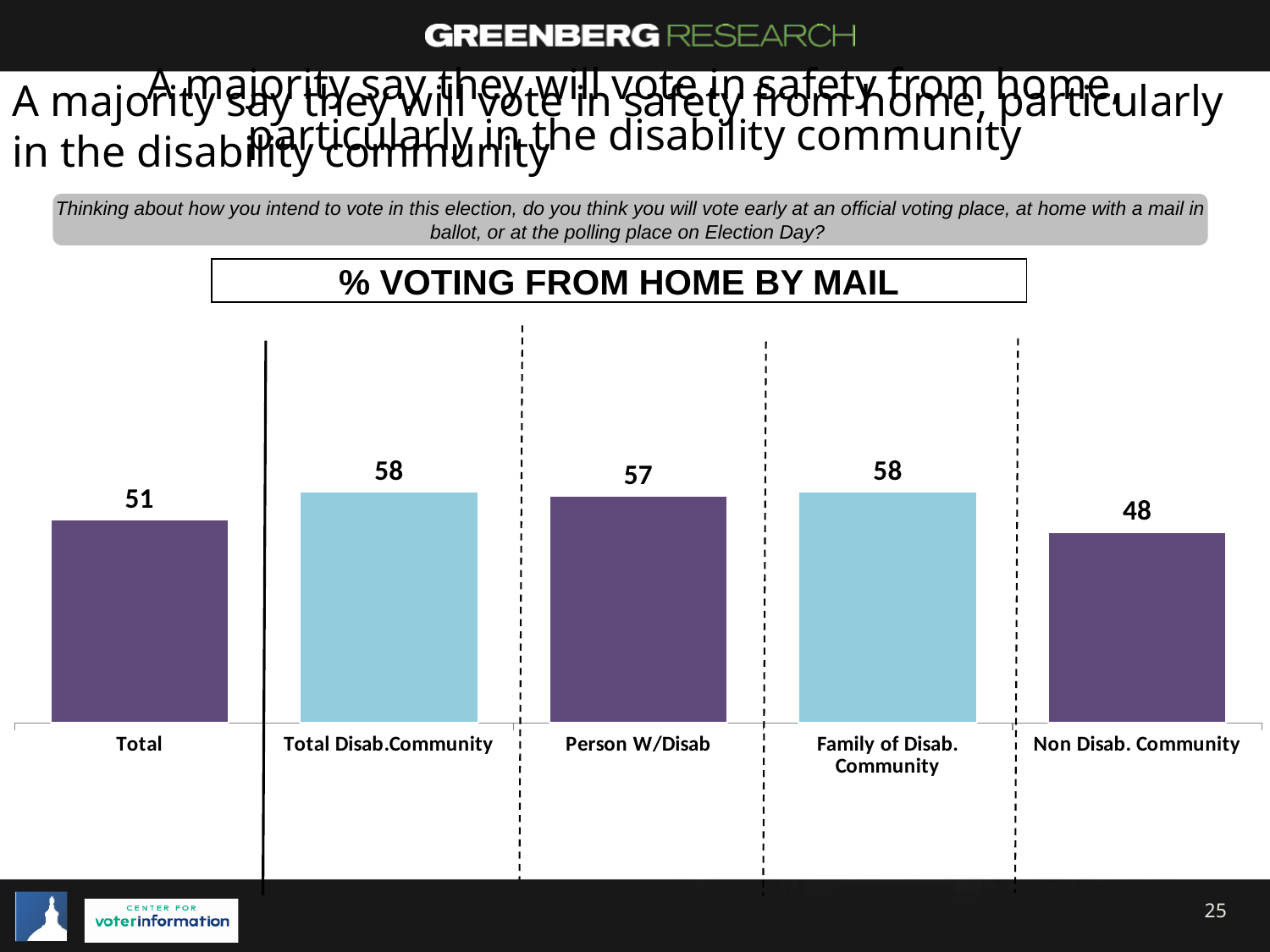
Which category has the lowest value? Non Disab. Community How many categories are shown in the chart? 5 What is the title of the chart? % VOTING FROM HOME BY MAIL What is the value for Person W/Disab? 57 What is the difference between the values for Total Disab.Community and Non Disab. Community? 10 What kind of chart is shown on the slide? Bar chart What is the value for Family of Disab. Community? 58 What is the difference between the values for Person W/Disab and Total? 6 What is the value for Total? 51 What is the value for Non Disab. Community? 48 Which two categories share the highest value of 58? Total Disab.Community and Family of Disab. Community Which is larger, the value for Total Disab.Community or the value for Total? Total Disab.Community